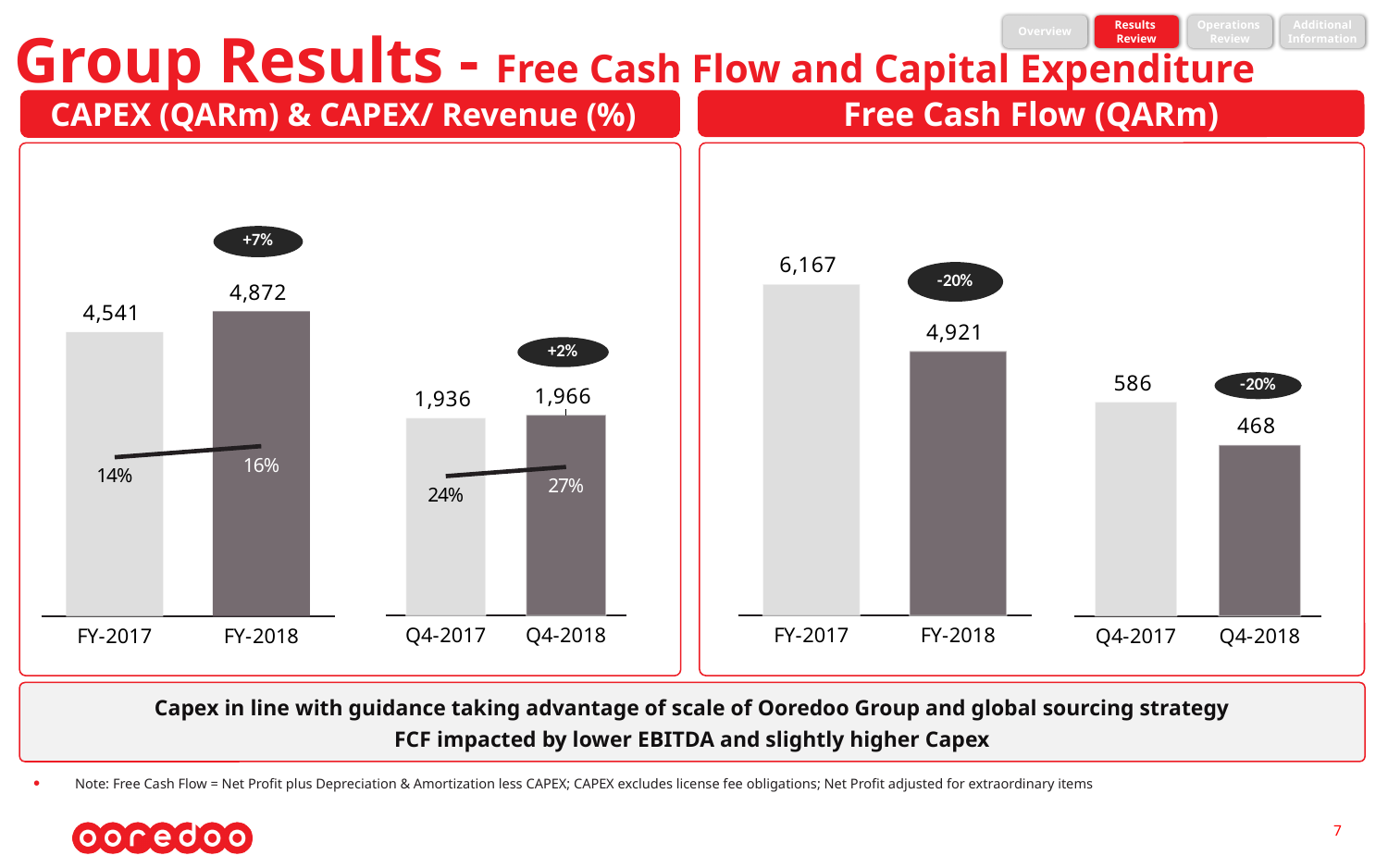
In the CAPEX (QARm) & CAPEX/ Revenue (%) chart, what is the CAPEX value for FY-2018? 4,872 In the CAPEX (QARm) & CAPEX/ Revenue (%) chart, what is the difference in CAPEX between FY-2018 and FY-2017? 331 In the CAPEX (QARm) & CAPEX/ Revenue (%) chart, what is the CAPEX value for Q4-2017? 1,936 In the Free Cash Flow (QARm) chart, what is the value for Q4-2018? 468 In the Free Cash Flow (QARm) chart, what percentage change is shown between Q4-2017 and Q4-2018? -20% In the CAPEX (QARm) & CAPEX/ Revenue (%) chart, what is the CAPEX/Revenue percentage for FY-2017? 14% In the Free Cash Flow (QARm) chart, what is the value for FY-2017? 6,167 In the Free Cash Flow (QARm) chart, what is the difference between FY-2017 and FY-2018? 1,246 In the CAPEX (QARm) & CAPEX/ Revenue (%) chart, what is the CAPEX/Revenue percentage for Q4-2018? 27% In the Free Cash Flow (QARm) chart, which period has the lowest value? Q4-2018 In the CAPEX (QARm) & CAPEX/ Revenue (%) chart, which period has the highest CAPEX value? FY-2018 What type of chart is the Free Cash Flow (QARm) chart? Bar chart